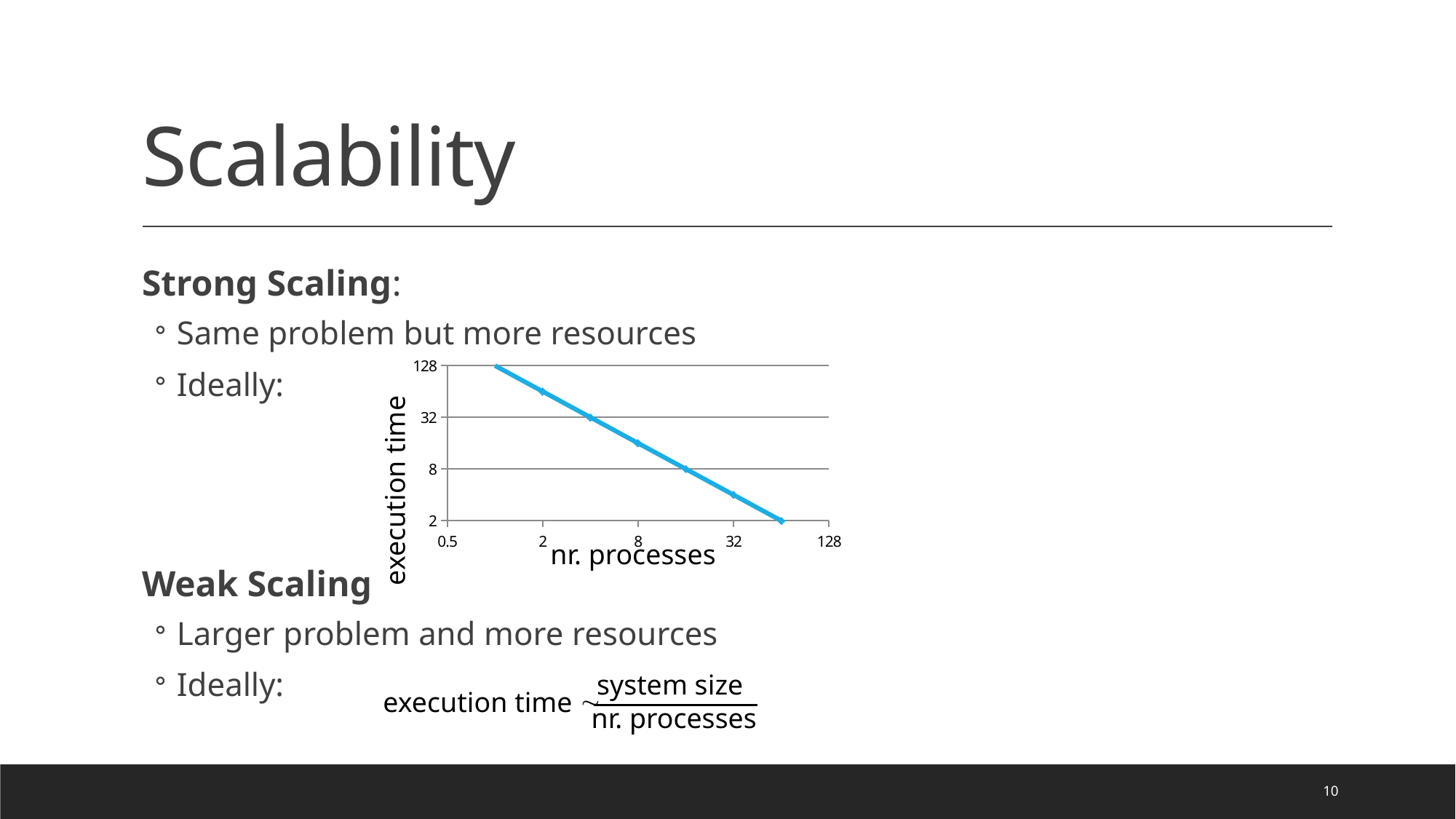
Is the execution time at 32 processes greater or less than 8? less Is the execution time at 8 processes greater or less than 32? less What is the label of the y axis of the chart? execution time Does execution time rise or fall as the number of processes increases along the x axis? fall How many data points are plotted on the line? 7 Is the execution time at 2 processes greater or less than 32? greater What is the label of the x axis of the chart? nr. processes Which has the higher execution time: 2 processes or 32 processes? 2 processes What is the highest tick value shown on the x axis? 128 What kind of chart is shown on the slide? line chart